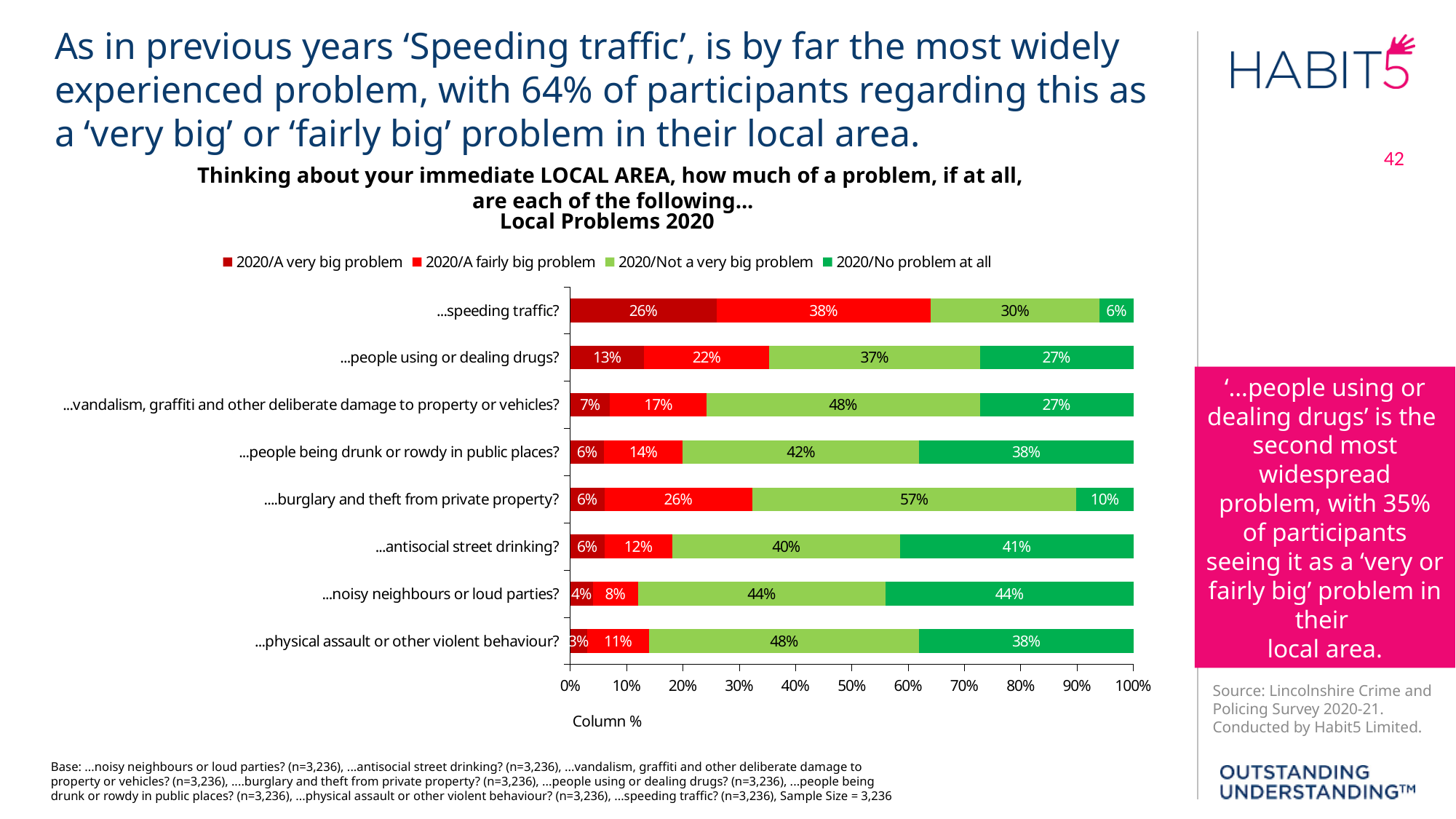
How many categories (local problems) are shown on the chart? 8 Which is larger: the 'No problem at all' value for '...antisocial street drinking?' or for '...noisy neighbours or loud parties?' ...noisy neighbours or loud parties? What is the label on the horizontal axis of the chart? Column % What percentage of participants said speeding traffic is 'A very big problem' in 2020? 26% Which category has the lowest 'A very big problem' value? ...physical assault or other violent behaviour? What is the 'Not a very big problem' value for '....burglary and theft from private property?' 57% What kind of chart is shown on the slide? Stacked bar chart How many series does the legend list? 4 What is the 'No problem at all' value for '...people being drunk or rowdy in public places?' 38% What is the difference between the 'A fairly big problem' values for '...speeding traffic?' and '...people using or dealing drugs?' 16% Which category has the highest 'A very big problem' value? ...speeding traffic? What is the combined 'A very big problem' and 'A fairly big problem' value for '...vandalism, graffiti and other deliberate damage to property or vehicles?' 24%